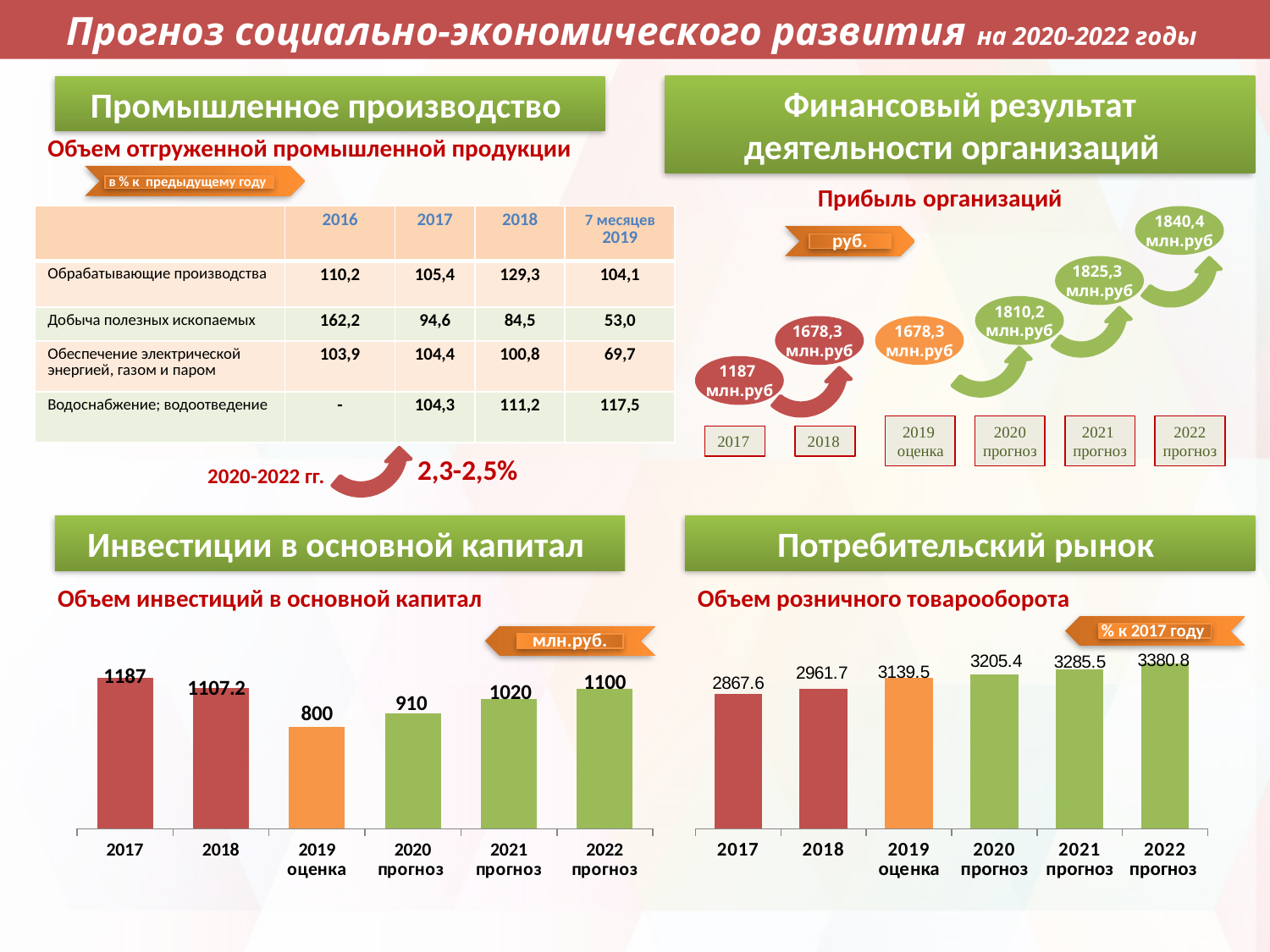
On the chart 'Объем инвестиций в основной капитал', what is the value for 2017? 1187 On the chart 'Объем розничного товарооборота', which is larger: the value for 2017 or the value for 2019 оценка? 2019 оценка On the chart 'Объем инвестиций в основной капитал', what is the difference between the 2022 прогноз value and the 2020 прогноз value? 190 On the chart 'Объем инвестиций в основной капитал', which year has the lowest value? 2019 оценка On the chart 'Объем розничного товарооборота', what is the value for 2022 прогноз? 3380.8 On the chart 'Объем инвестиций в основной капитал', how many bars are plotted? 6 What kind of chart is 'Объем розничного товарооборота'? bar chart On the chart 'Объем розничного товарооборота', what is the value for 2018? 2961.7 On the chart 'Объем розничного товарооборота', which year has the highest value? 2022 прогноз On the chart 'Объем инвестиций в основной капитал', what is the value for 2019 оценка? 800 On the chart 'Объем инвестиций в основной капитал', do the values rise or fall from 2019 оценка to 2022 прогноз? rise On the chart 'Объем розничного товарооборота', what is the difference between the 2021 прогноз value and the 2020 прогноз value? 80.1